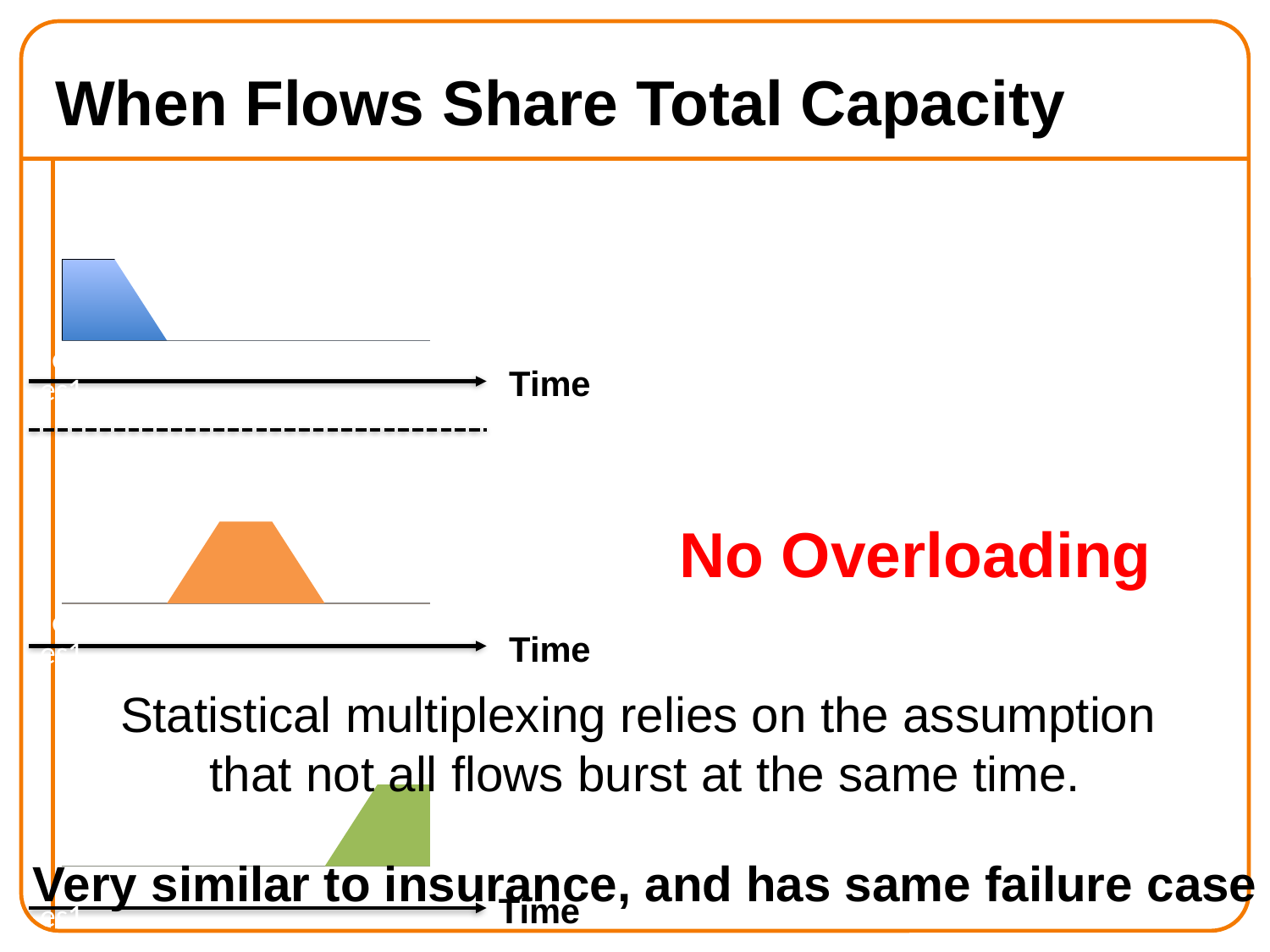
In the bottom chart, does the green flow's value rise or fall along the time axis? rise What kind of chart is the top chart on the slide? area chart What colour is the filled area in the middle chart? orange What is the x-axis label of the top chart? Time In the top chart, does the blue flow's value rise or fall along the time axis? fall How many charts are shown on the slide? 3